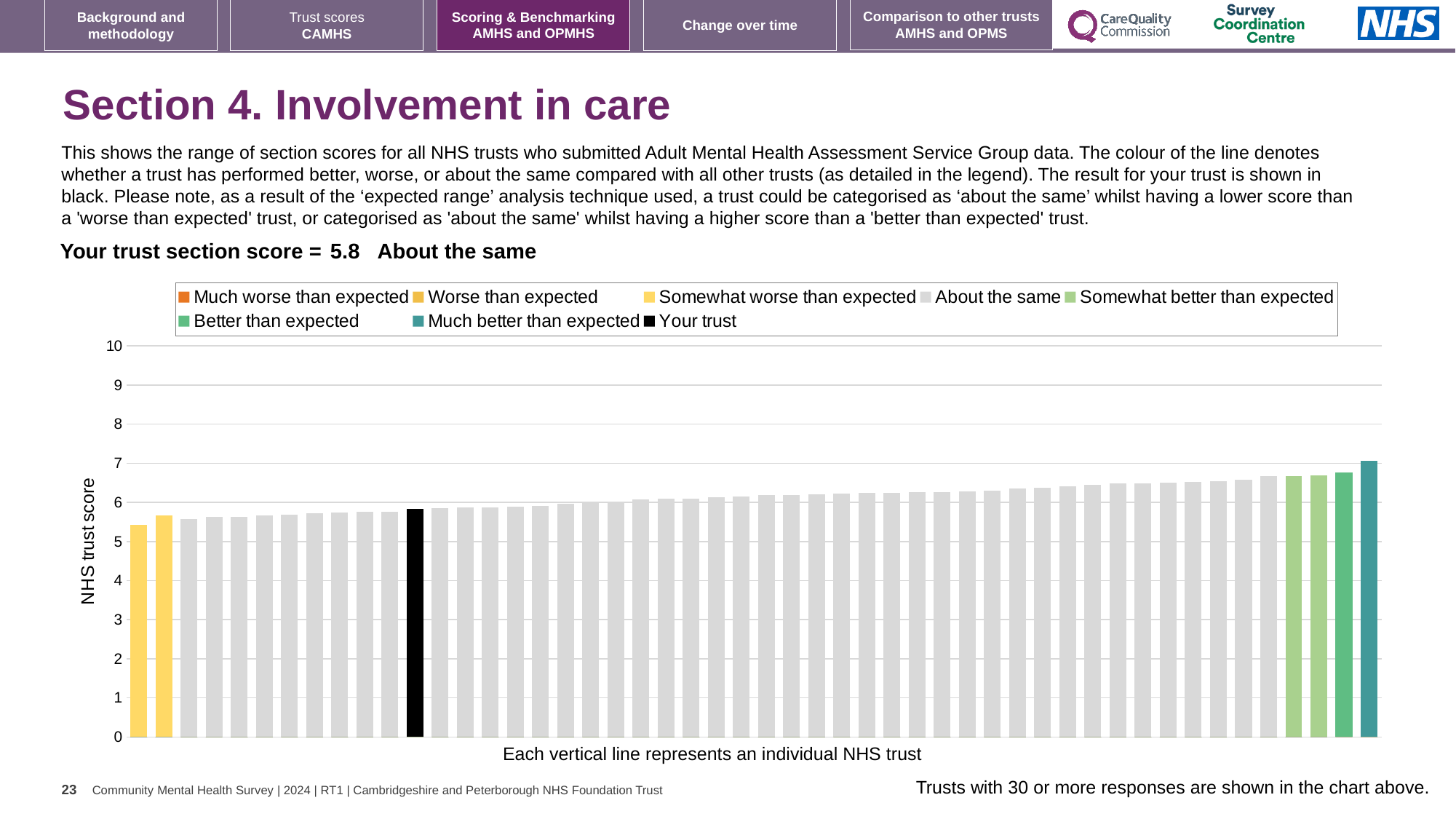
Is the value of the tallest bar (the teal 'Much better than expected' bar) greater or less than 6? greater Which legend category does the tallest bar in the chart belong to? Much better than expected What is your trust's section score shown on the slide? 5.8 Do the bar values rise or fall from left to right along the x axis? rise What is the label on the vertical axis of the chart? NHS trust score Is the 'Your trust' bar higher or lower than the teal 'Much better than expected' bar? lower Is the value of the black 'Your trust' bar greater or less than 5? greater Is the value of the leftmost (lowest) bar greater or less than 6? less What kind of chart is shown on the slide? bar chart How many entries does the chart legend list? 8 Which performance category is your trust placed in for this section? About the same How many bars are coloured as 'Somewhat worse than expected' (yellow)? 2